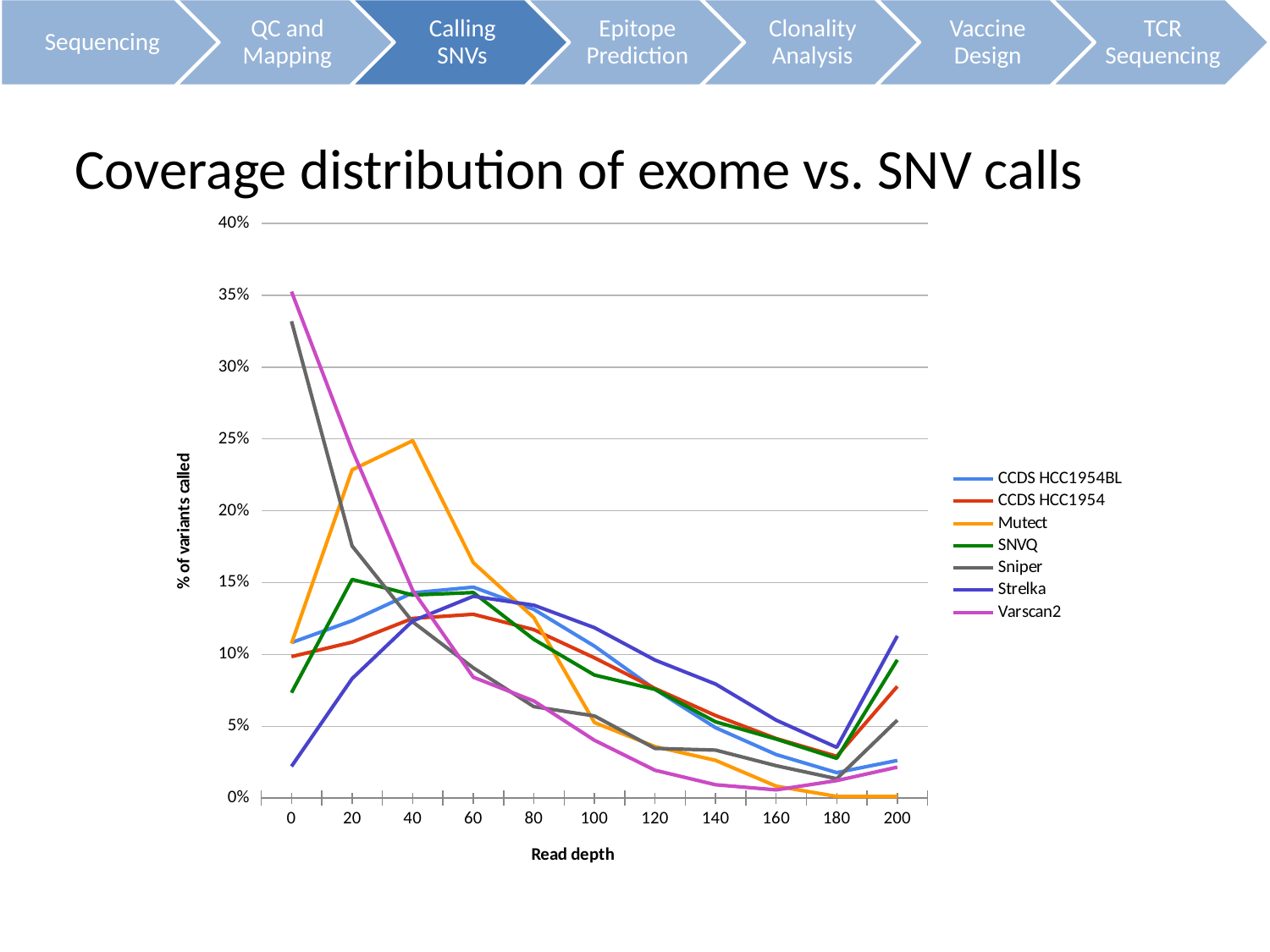
At read depth 40, which is larger: the value for Mutect or the value for Varscan2? Mutect Which series has the lowest value at read depth 0? Strelka How many series does the legend list? 7 Is the value for Mutect at read depth 40 greater or less than 20%? greater Is the value for Varscan2 at read depth 0 greater or less than 30%? greater How many read depth points are marked along the x axis? 11 Is the value for Strelka at read depth 0 greater or less than 5%? less Which series has the highest value at read depth 200? Strelka What is the title of the x axis? Read depth What kind of chart is shown on the slide? line chart Which series has the highest value at read depth 0? Varscan2 Which series has the lowest value at read depth 200? Mutect